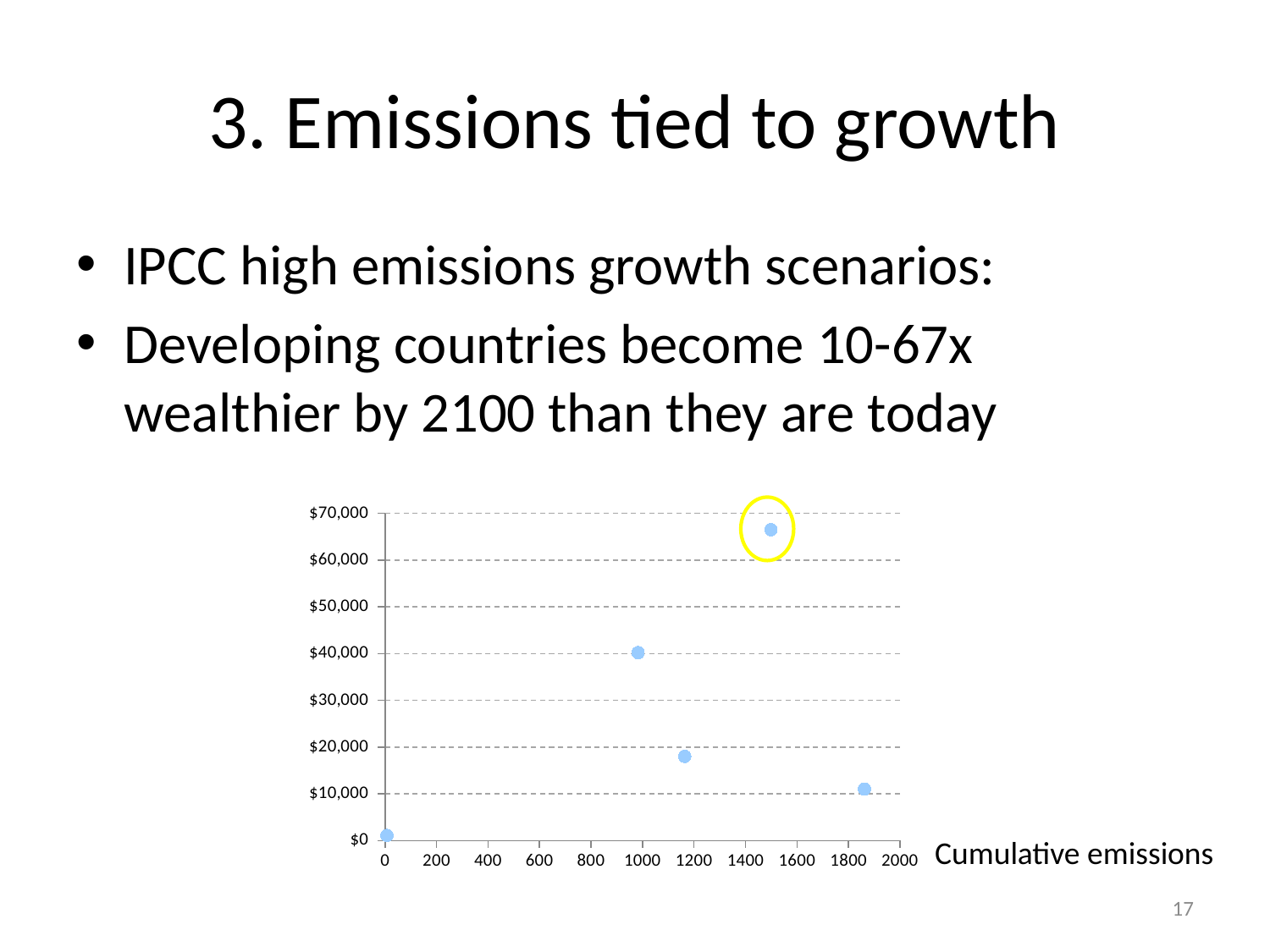
Which point has the lowest value on the chart? the point at 0 on the x axis Is the value of the point near 1000 on the x axis greater or less than $30,000? greater Is the value of the point near 1800 on the x axis greater or less than $20,000? less Is the value of the highest point on the chart greater or less than $60,000? greater Which has the higher value: the point near 1000 on the x axis or the point near 1200 on the x axis? the point near 1000 Which data point is highlighted with a yellow circle on the chart? the highest point, near 1500 on the x axis How many data points are plotted on the chart? 5 What is the highest value shown on the y axis of the chart? $70,000 What is the label of the x axis of the chart? Cumulative emissions What kind of chart is shown on the slide? scatter chart